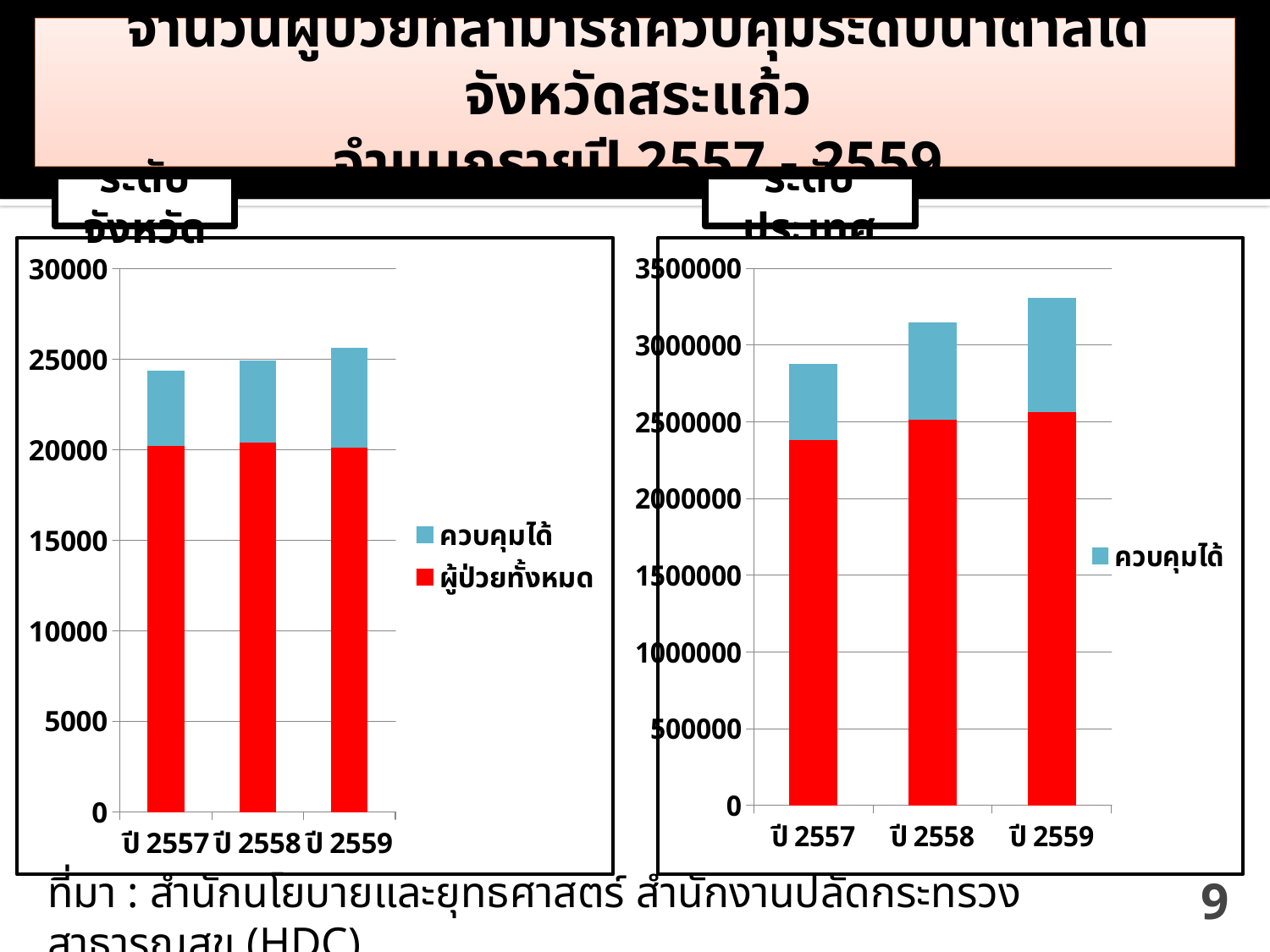
What kind of chart is the left chart (ระดับจังหวัด)? Stacked bar chart In the right chart (ระดับประเทศ), is the total height of the stacked bar for ปี 2557 greater or less than 3000000? less In the left chart (ระดับจังหวัด), which colour represents ควบคุมได้? Blue How many year categories are shown on the x axis of the left chart (ระดับจังหวัด)? 3 In the right chart (ระดับประเทศ), is the red segment for ปี 2557 greater or less than 2500000? less In the left chart (ระดับจังหวัด), is the ผู้ป่วยทั้งหมด (red) value for ปี 2558 greater or less than 25000? less In the right chart (ระดับประเทศ), which year has the tallest stacked bar overall? ปี 2559 In the left chart (ระดับจังหวัด), which year has the tallest stacked bar overall? ปี 2559 In the right chart (ระดับประเทศ), does the total height of the stacked bars rise or fall from ปี 2557 to ปี 2559? Rise How many series does the legend of the left chart (ระดับจังหวัด) list? 2